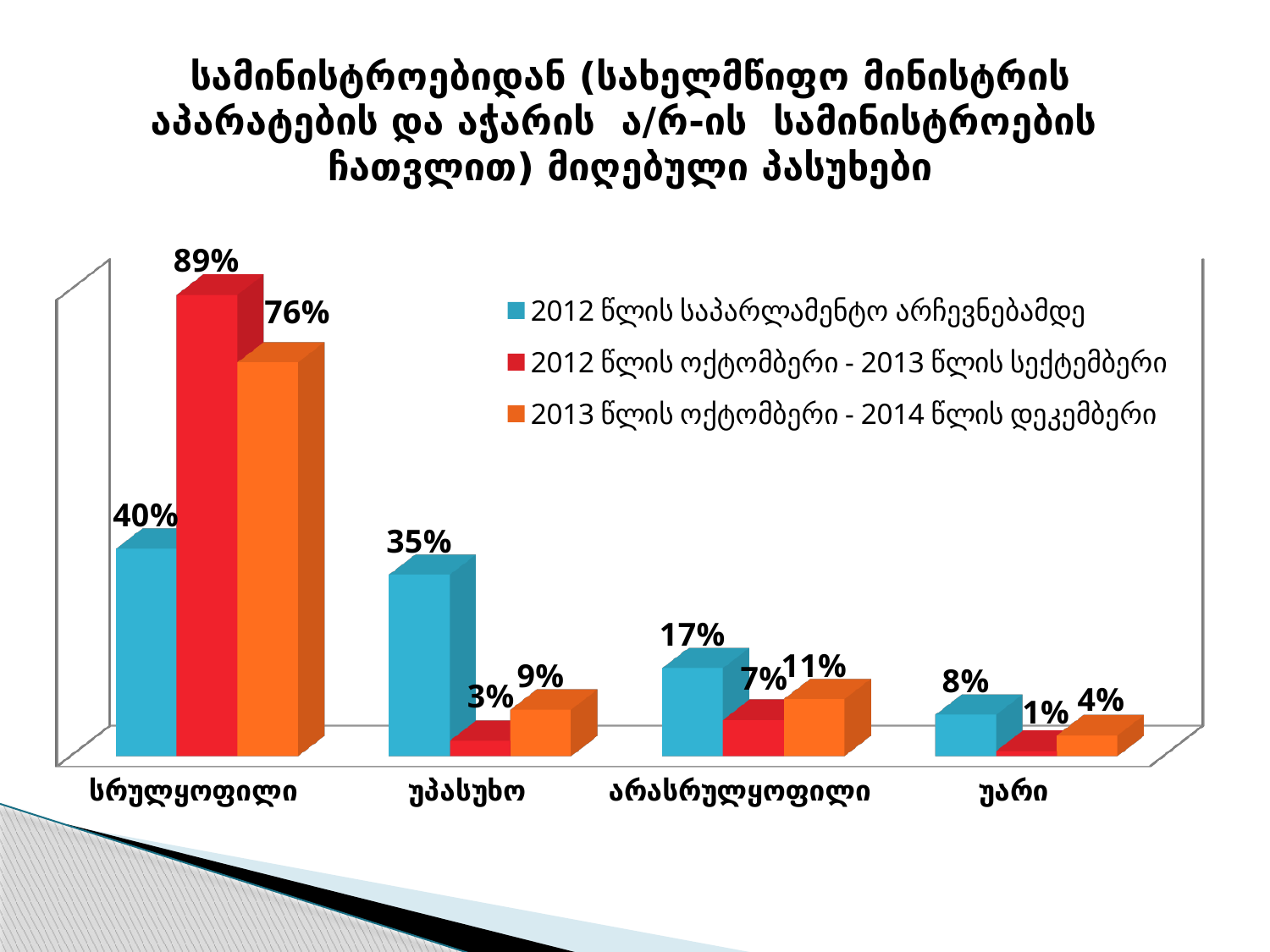
What is the value for უპასუხო in the series 2012 წლის საპარლამენტო არჩევნებამდე? 35% How many series does the legend list? 3 What is the value for სრულყოფილი in the series 2012 წლის ოქტომბერი - 2013 წლის სექტემბერი? 89% What is the difference between the 2012 წლის ოქტომბერი - 2013 წლის სექტემბერი and 2013 წლის ოქტომბერი - 2014 წლის დეკემბერი values for სრულყოფილი? 13% Which category has the highest value in the series 2013 წლის ოქტომბერი - 2014 წლის დეკემბერი? სრულყოფილი What is the value for უარი in the series 2013 წლის ოქტომბერი - 2014 წლის დეკემბერი? 4% Which category has the lowest value in the series 2012 წლის საპარლამენტო არჩევნებამდე? უარი For უპასუხო, which series has the larger value: 2012 წლის ოქტომბერი - 2013 წლის სექტემბერი or 2013 წლის ოქტომბერი - 2014 წლის დეკემბერი? 2013 წლის ოქტომბერი - 2014 წლის დეკემბერი What kind of chart is shown on the slide? Bar chart How many categories are shown on the x axis of the chart? 4 Which colour represents the series 2012 წლის საპარლამენტო არჩევნებამდე? Blue What is the value for არასრულყოფილი in the series 2012 წლის ოქტომბერი - 2013 წლის სექტემბერი? 7%